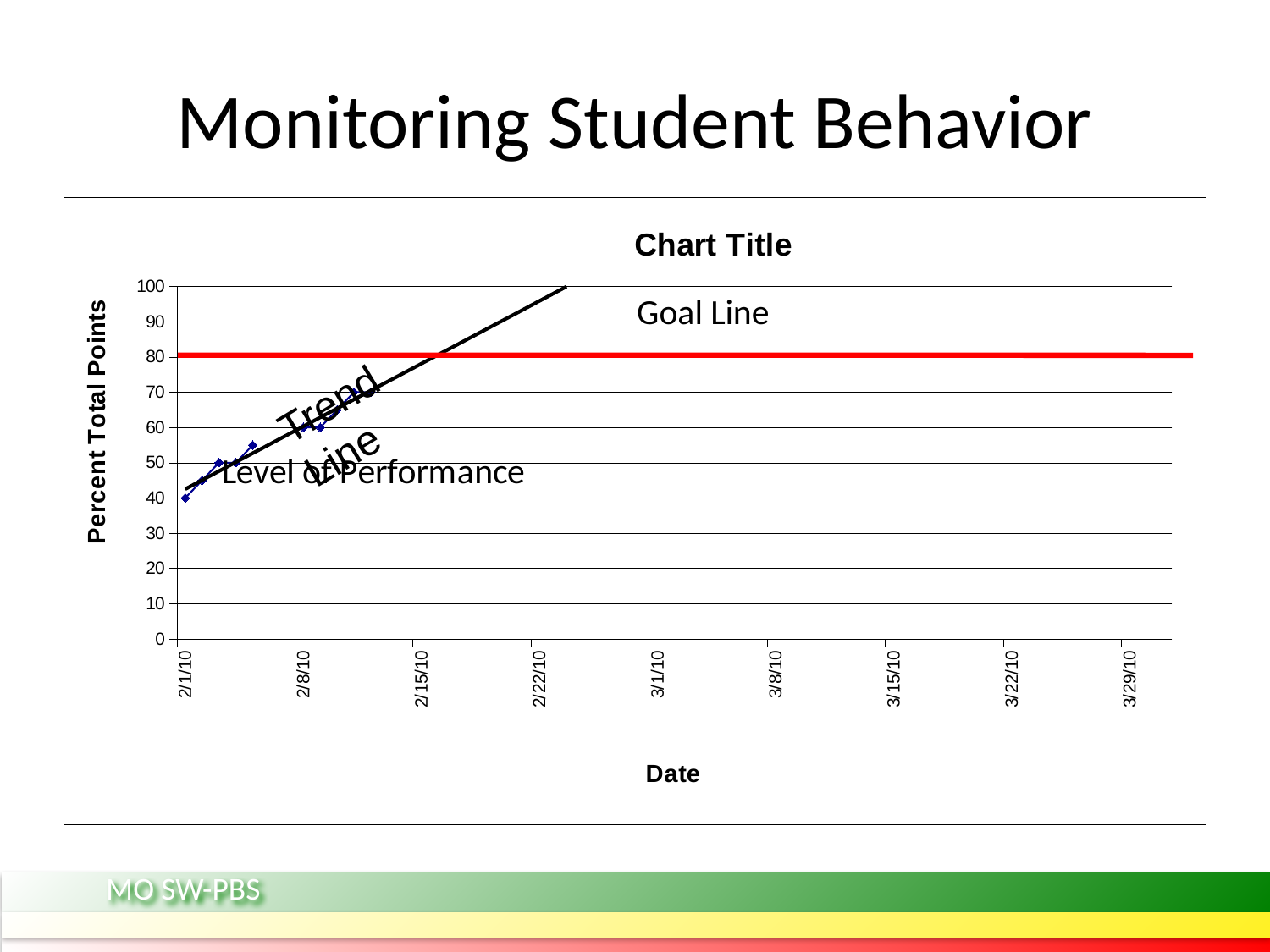
Is the Goal Line greater or less than 70? greater At what value on the y axis is the Goal Line drawn? 80 Is the Level of Performance value on 2/1/10 greater or less than 50? less Is the last plotted Level of Performance point above or below the Goal Line? below What is the title of the x axis? Date What is the Level of Performance value on 2/1/10? 40 How many date labels are shown on the x axis? 9 Do the Level of Performance values rise or fall along the x axis? rise What is the title of the y axis? Percent Total Points Which date label appears first on the x axis? 2/1/10 What kind of chart is shown on the slide? line chart